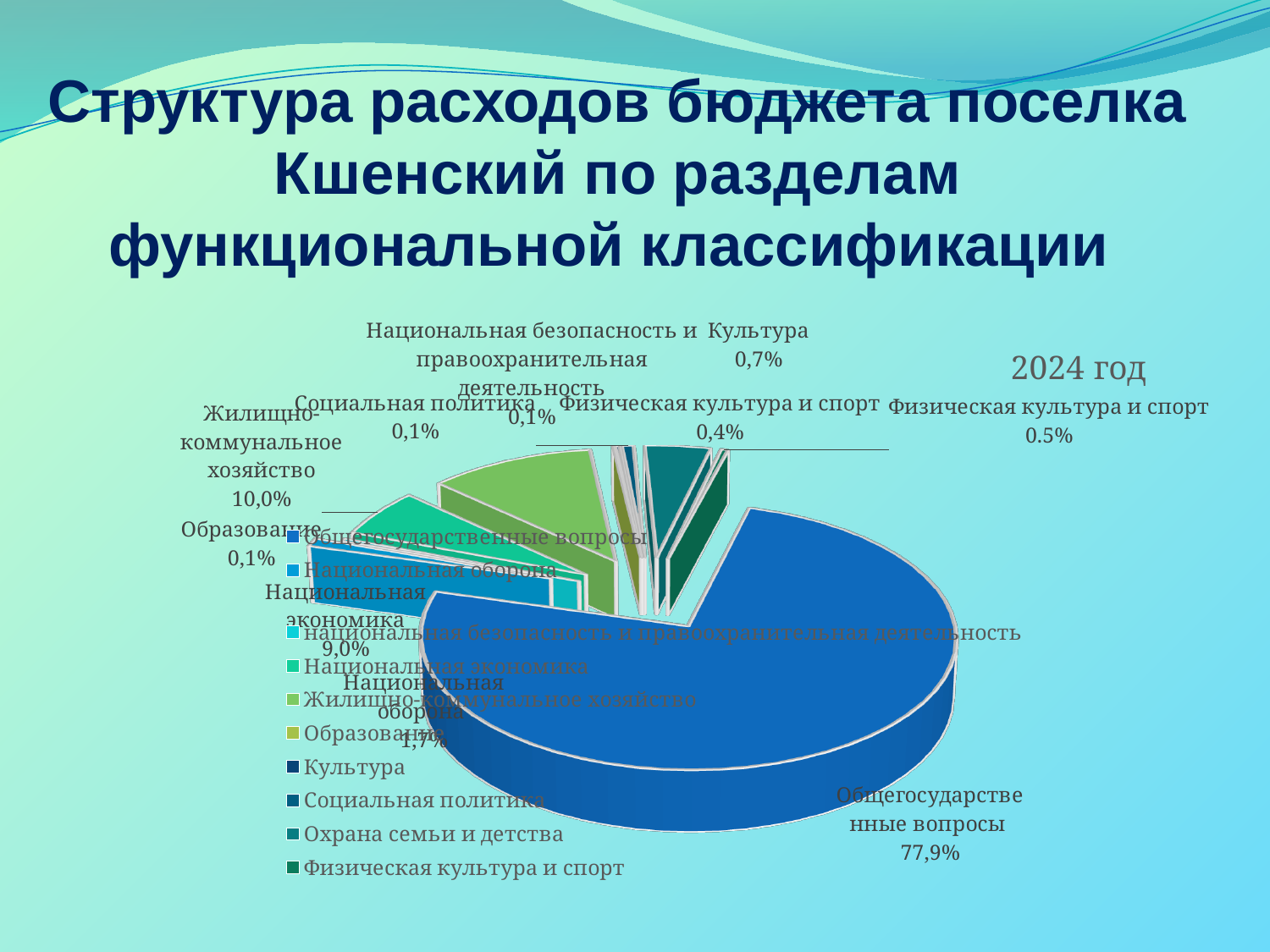
What kind of chart is shown on the slide? Pie chart What share is shown for Жилищно-коммунальное хозяйство? 10,0% How many entries does the chart legend list? 10 Which category has the largest share of the pie? Общегосударственные вопросы What share is shown for Социальная политика? 0,1% What share is shown for Общегосударственные вопросы? 77,9% What share is shown for Культура? 0,7% What is the difference between the shares of Жилищно-коммунальное хозяйство and Национальная экономика? 1,0% What is the difference between the shares of Общегосударственные вопросы and Жилищно-коммунальное хозяйство? 67,9% Which has the larger share: Национальная экономика or Национальная оборона? Национальная экономика What share is shown for Национальная экономика? 9,0% What share is shown for Национальная оборона? 1,7%